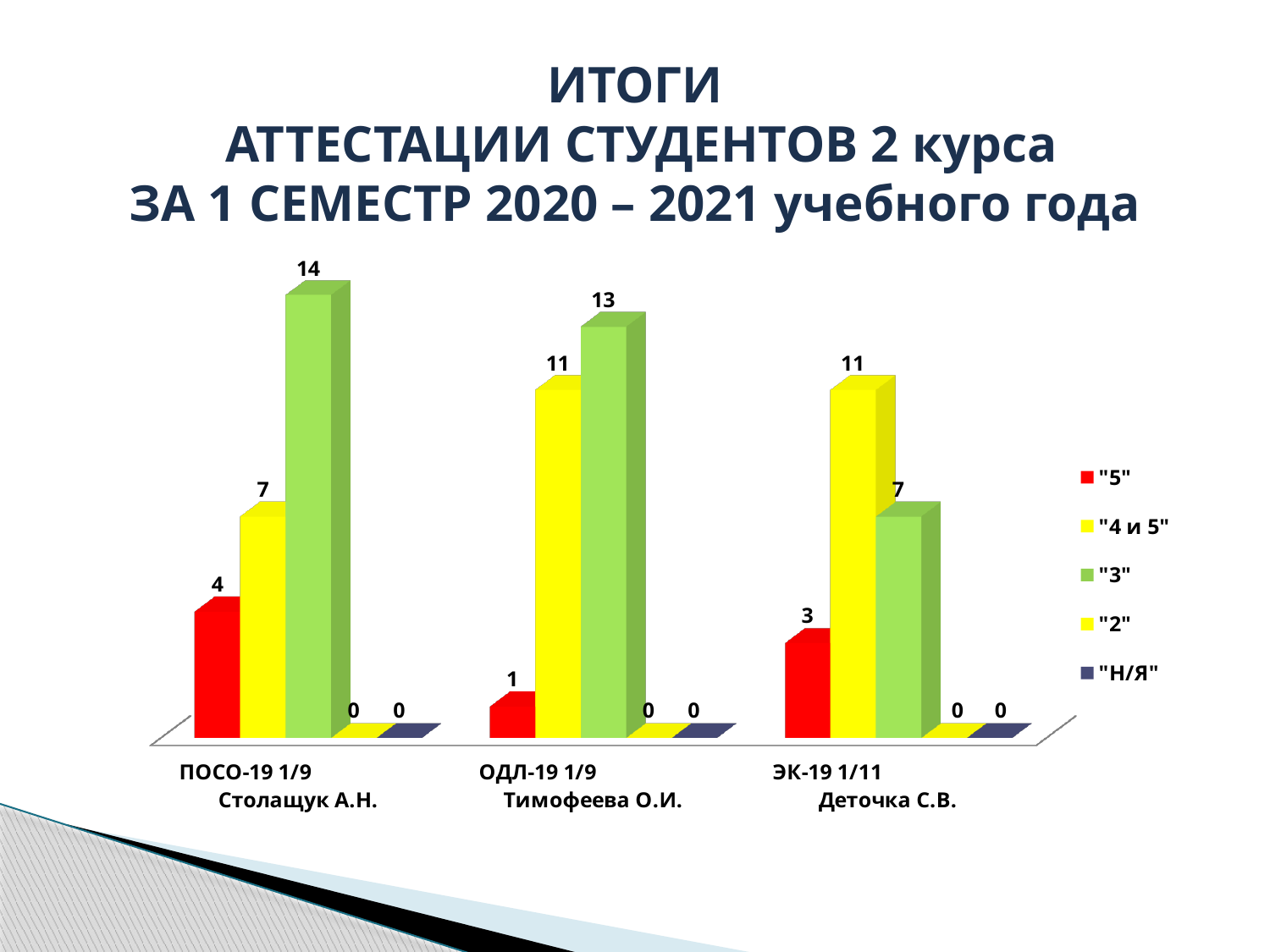
How many series does the legend list? 5 For ЭК-19 1/11 Деточка С.В., which is larger: the "4 и 5" value or the "3" value? "4 и 5" Which group has the lowest value for the "5" series? ОДЛ-19 1/9 Тимофеева О.И. What colour are the bars for the "3" series? green What is the value of the "4 и 5" series for ОДЛ-19 1/9 Тимофеева О.И.? 11 Which group has the highest value for the "3" series? ПОСО-19 1/9 Столащук А.Н. What is the value of the "5" series for ЭК-19 1/11 Деточка С.В.? 3 What is the difference between the "3" value and the "4 и 5" value for ПОСО-19 1/9 Столащук А.Н.? 7 What is the value of the "3" series for ПОСО-19 1/9 Столащук А.Н.? 14 How many groups (categories) are shown on the x axis? 3 What kind of chart is shown on the slide? bar chart What is the value of the "Н/Я" series for ОДЛ-19 1/9 Тимофеева О.И.? 0